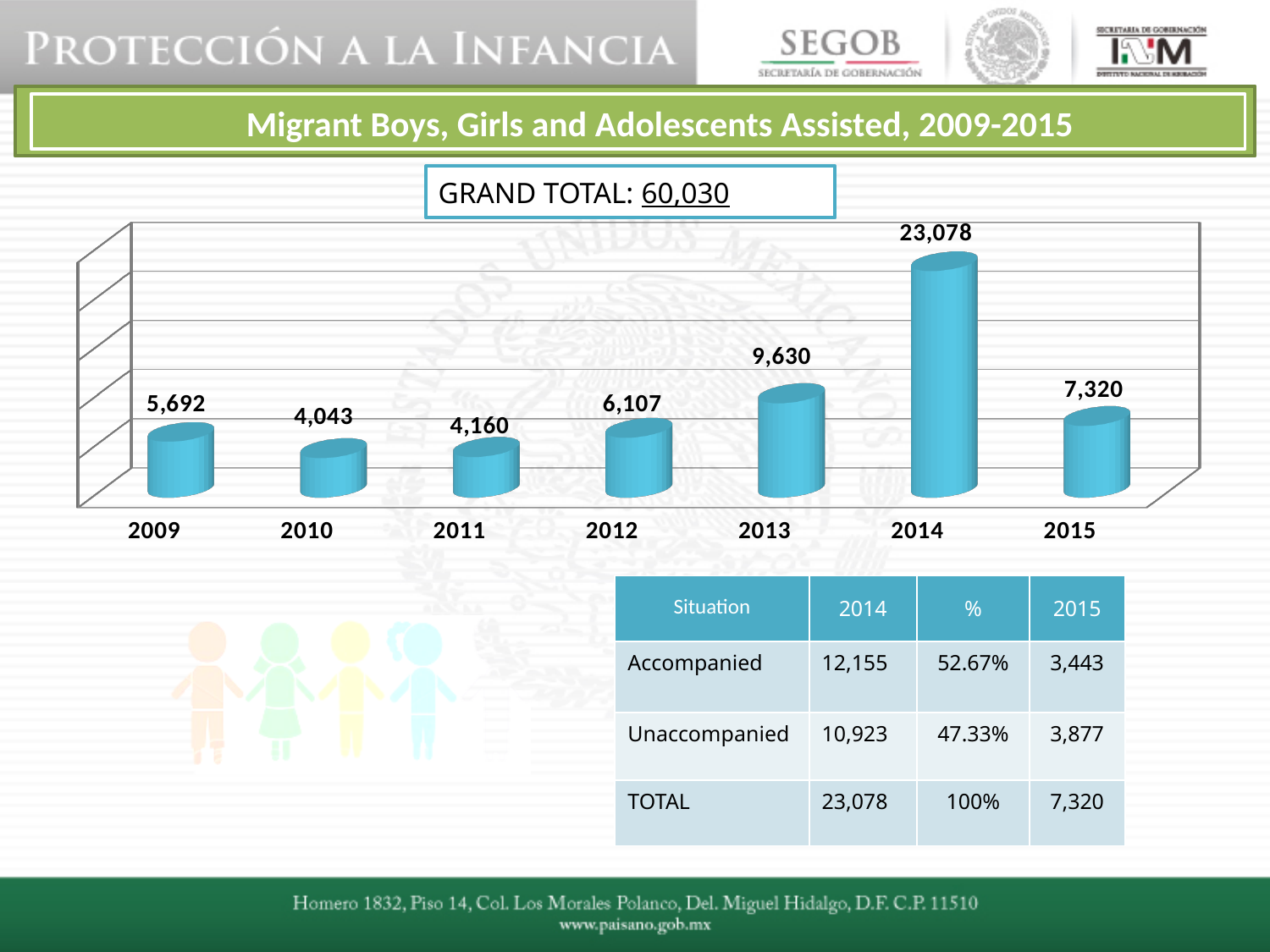
What value is shown for 2009? 5,692 What value is shown for 2014? 23,078 What is the grand total shown above the chart? 60,030 What kind of chart is shown? bar chart Which year has the highest value? 2014 Which year has the lowest value? 2010 How many years are shown on the x axis? 7 Do the values rise or fall from 2011 to 2014? rise What is the difference between the values for 2014 and 2015? 15,758 What value is shown for 2012? 6,107 Which is larger, the value for 2011 or the value for 2015? 2015 What is the difference between the values for 2013 and 2012? 3,523